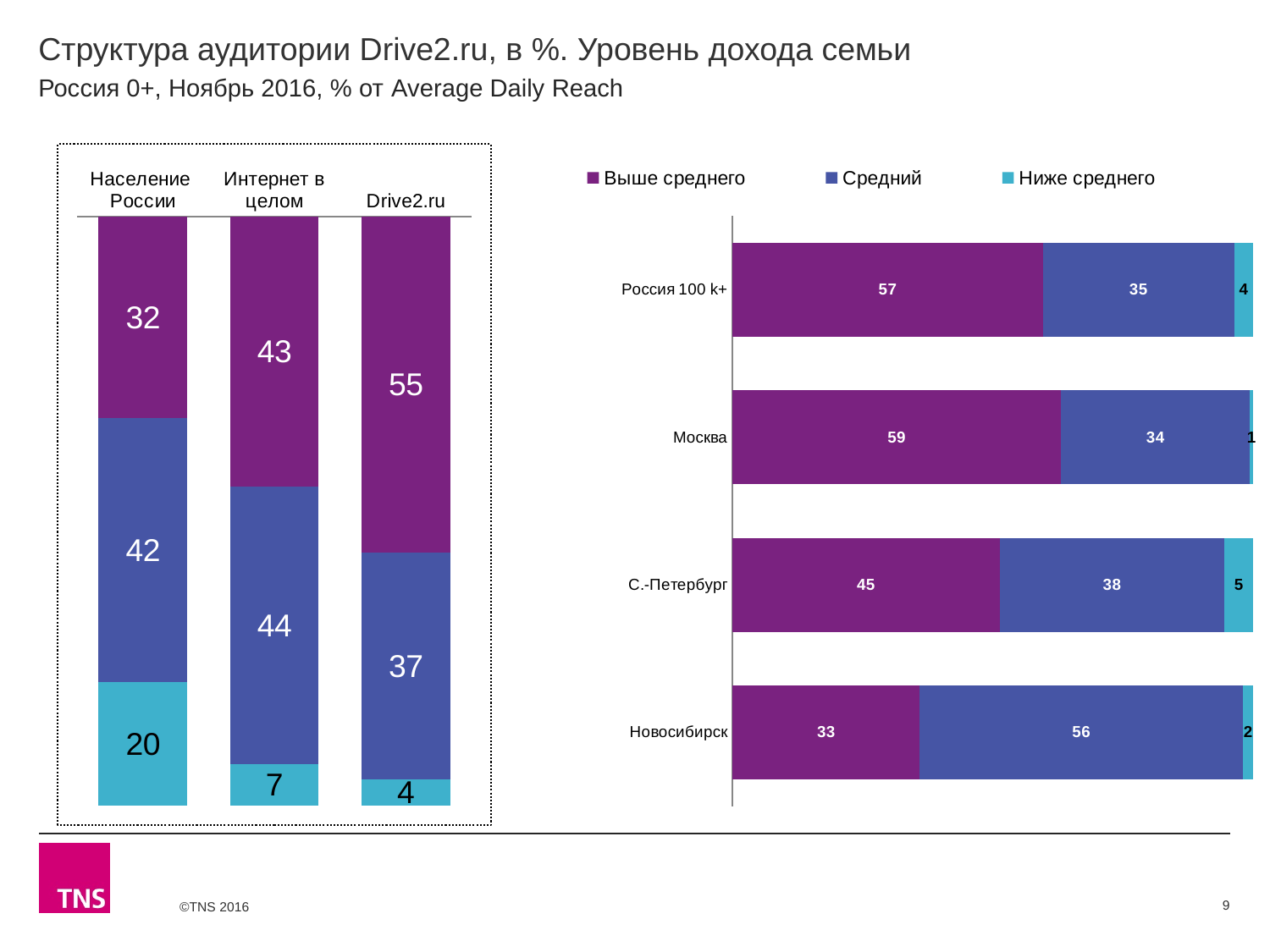
In the right chart, what is the 'Выше среднего' value for Москва? 59 In the right chart, is the 'Выше среднего' value larger for Россия 100 k+ or for Новосибирск? Россия 100 k+ In the left chart, which category has the lowest 'Ниже среднего' value? Drive2.ru In the right chart, which city or region has the highest 'Ниже среднего' value? С.-Петербург In the right chart, what is the 'Средний' value for Новосибирск? 56 In the left chart, what is the difference between the 'Средний' values for Интернет в целом and Drive2.ru? 7 In the left chart, which category has the highest 'Выше среднего' value? Drive2.ru In the right chart, what is the difference between the 'Выше среднего' values for Москва and С.-Петербург? 14 In the left chart, what is the value of the 'Выше среднего' segment for Drive2.ru? 55 What type of chart is the right chart? Stacked bar chart In the left chart, what is the value of the 'Ниже среднего' segment for Население России? 20 How many series does the legend of the right chart list? 3